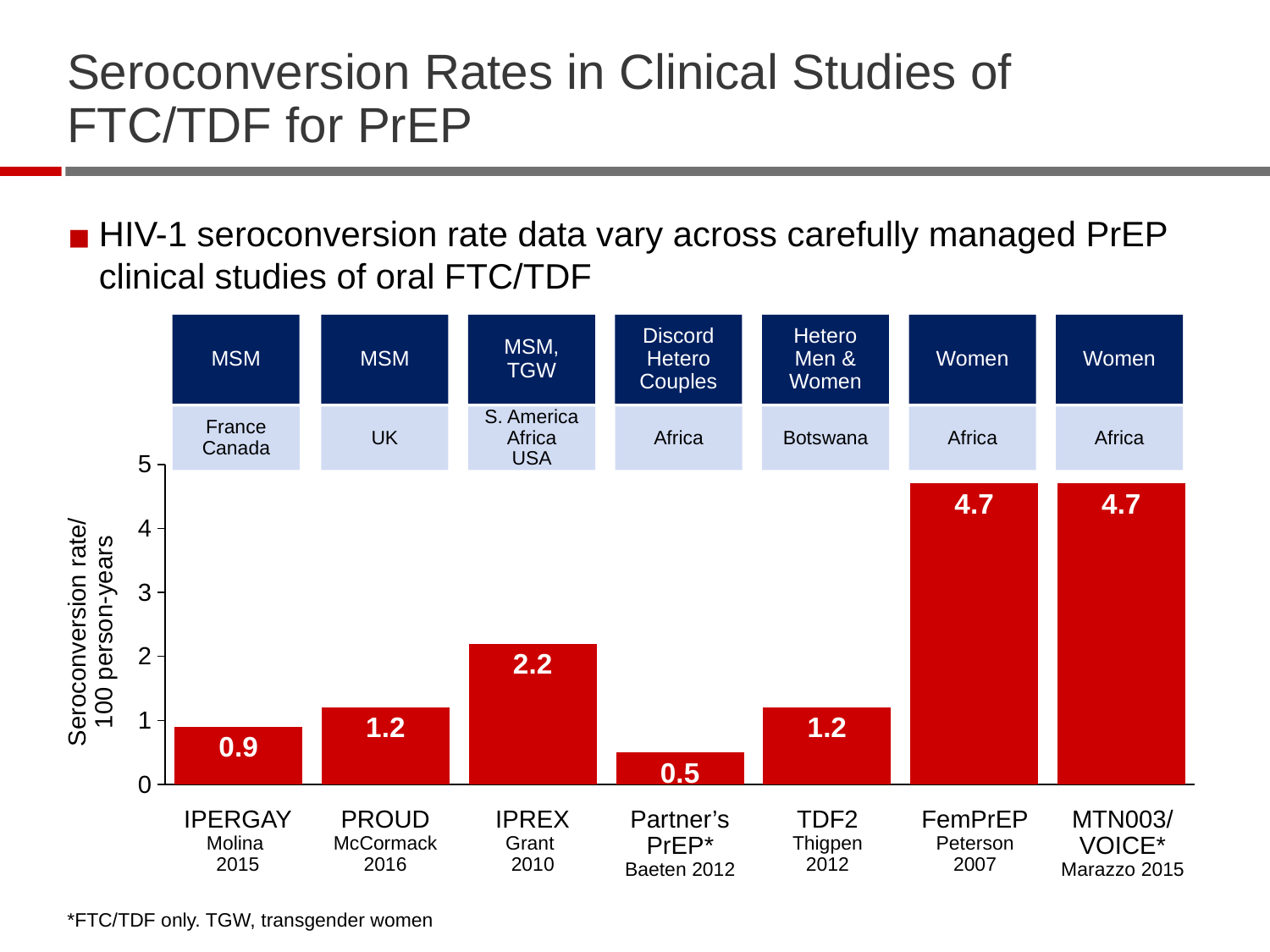
How many studies are shown as bars in the chart? 7 What kind of chart is shown on the slide? Bar chart What is the label of the vertical axis of the chart? Seroconversion rate/100 person-years What is the seroconversion rate per 100 person-years for the IPREX study? 2.2 What is the difference in seroconversion rate between FemPrEP and IPREX? 2.5 Which study has the lowest seroconversion rate? Partner's PrEP What is the difference in seroconversion rate between PROUD and IPERGAY? 0.3 Is the seroconversion rate for FemPrEP greater or less than 4? greater Which has a higher seroconversion rate, IPREX or TDF2? IPREX What is the seroconversion rate per 100 person-years for the IPERGAY study? 0.9 What is the seroconversion rate per 100 person-years for the Partner's PrEP study? 0.5 Which population is listed above the PROUD study bar? MSM